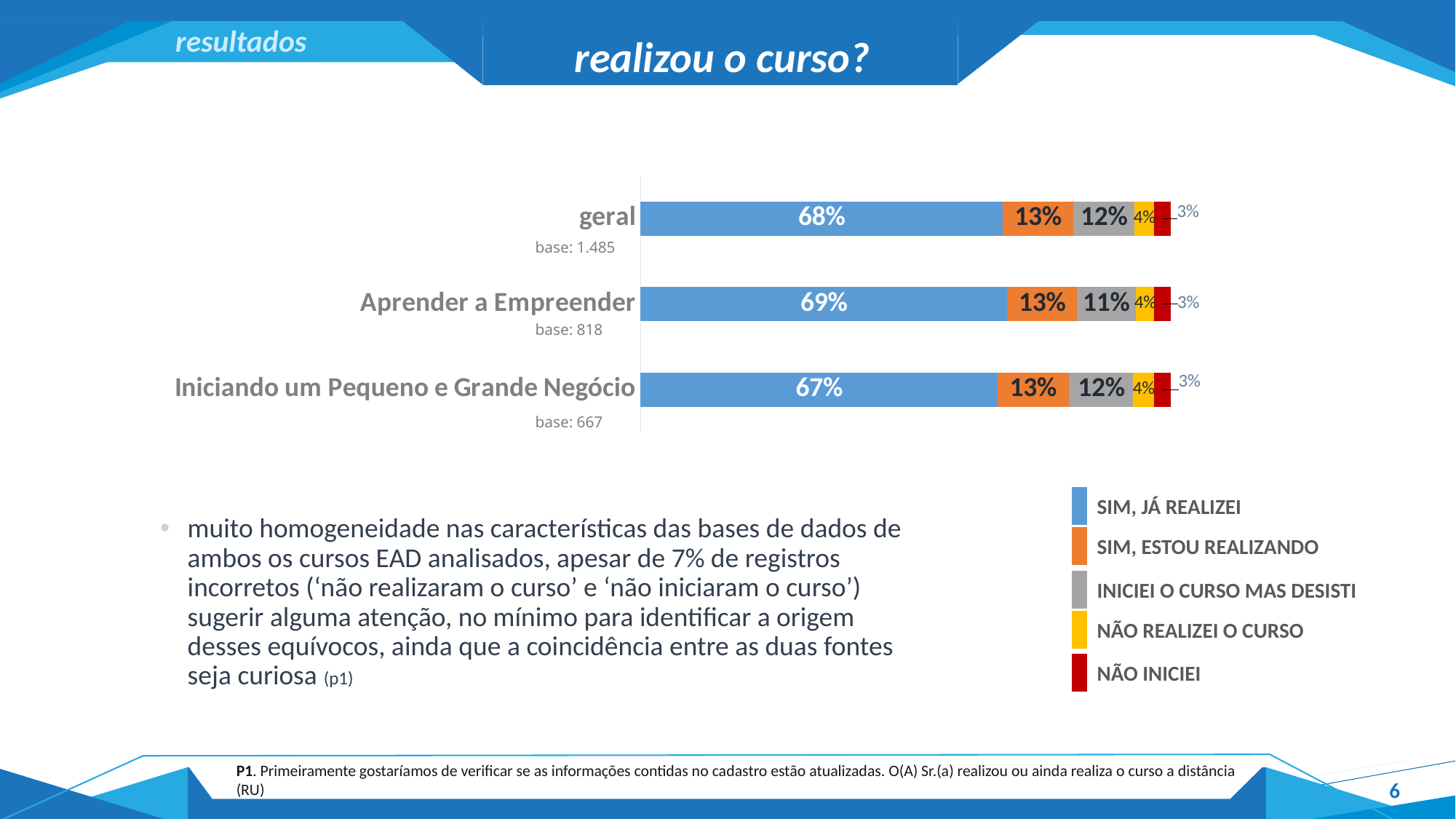
How many series does the legend list? 5 What is the value of 'SIM, JÁ REALIZEI' for 'geral'? 68% What is the base (number of respondents) shown for 'geral'? 1.485 What is the difference between the 'SIM, JÁ REALIZEI' values for 'Aprender a Empreender' and 'Iniciando um Pequeno e Grande Negócio'? 2% What is the value of 'INICIEI O CURSO MAS DESISTI' for 'Iniciando um Pequeno e Grande Negócio'? 12% How many categories (bars) does the chart show? 3 What kind of chart is shown on the slide? stacked bar chart What is the value of 'NÃO INICIEI' for 'geral'? 3% Which category has the highest value for 'SIM, JÁ REALIZEI'? Aprender a Empreender Which category has the lowest value for 'SIM, JÁ REALIZEI'? Iniciando um Pequeno e Grande Negócio What is the value of 'SIM, JÁ REALIZEI' for 'Aprender a Empreender'? 69% What is the total of the stacked bar for 'geral'? 100%